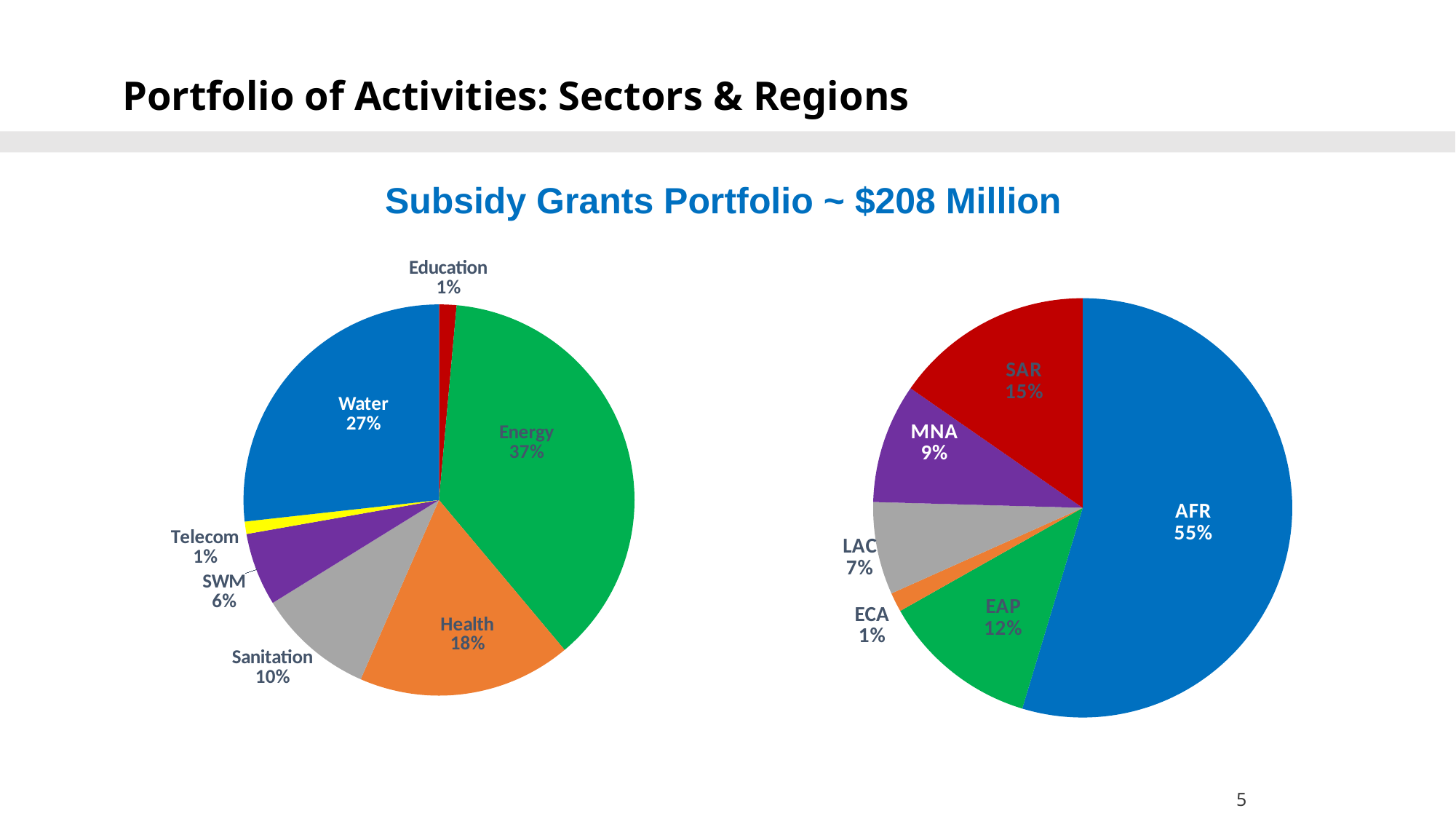
In the right pie chart (regions), what is the difference between the MNA share and the LAC share? 2% In the right pie chart (regions), which is larger, SAR or EAP? SAR In the left pie chart (sectors), what share does Energy have? 37% In the right pie chart (regions), which region has the smallest share? ECA In the left pie chart (sectors), which sector has the largest share? Energy In the left pie chart (sectors), what is the difference between the Water share and the Health share? 9% How many regions are shown in the right pie chart? 6 In the left pie chart (sectors), what share does Sanitation have? 10% What is the approximate total value of the Subsidy Grants Portfolio stated in the heading above the charts? $208 Million What type of chart is used on the left of the slide? Pie chart How many sectors are shown in the left pie chart? 7 In the right pie chart (regions), what share does AFR have? 55%